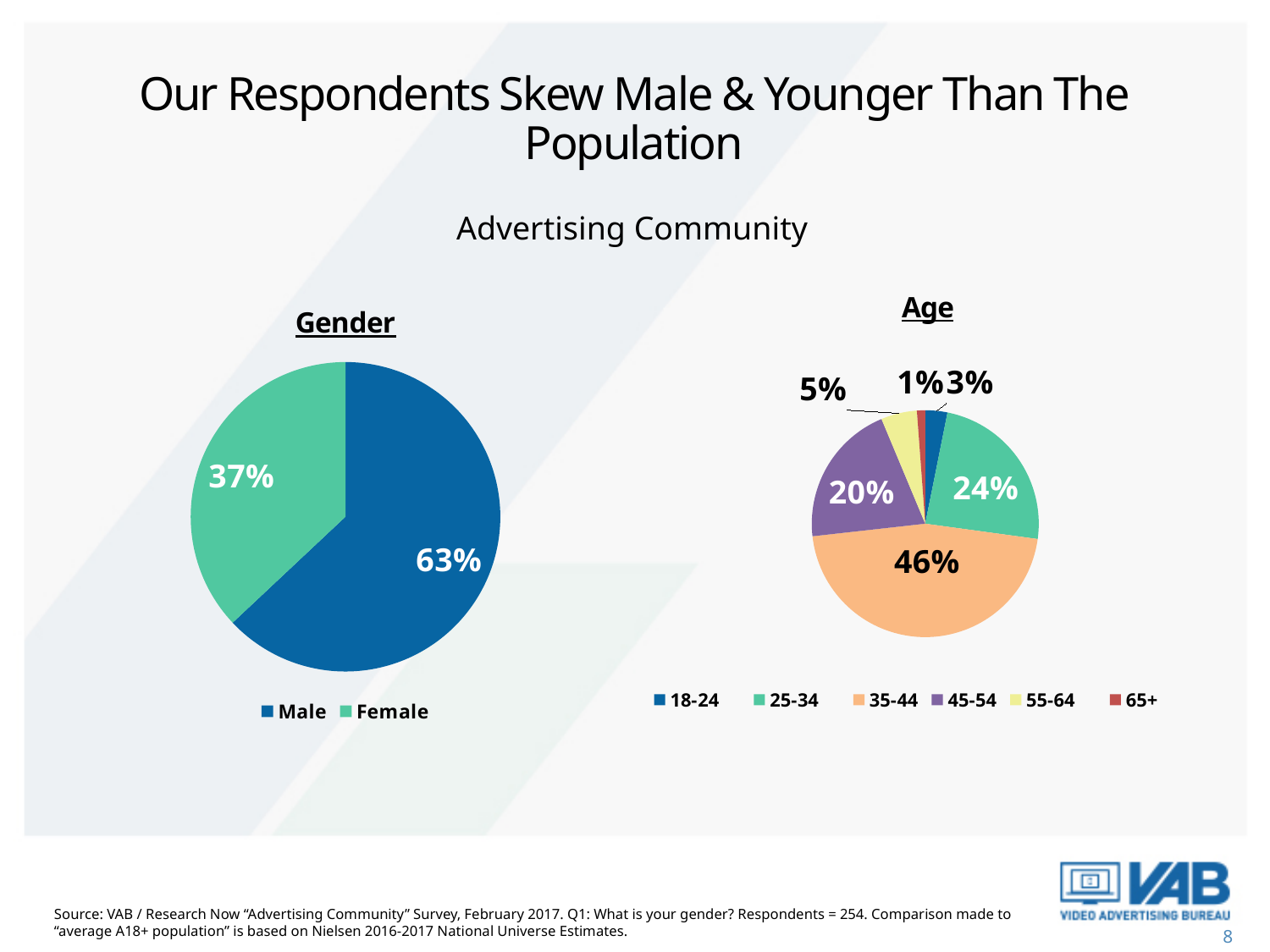
On the Age chart, what is the combined share of the 35-44 and 45-54 groups? 66% On the Age chart, which age group has the smallest share? 65+ On the Age chart, which age group has the largest share? 35-44 On the Age chart, what percentage of respondents are aged 45-54? 20% On the Age chart, what percentage of respondents are aged 35-44? 46% On the Age chart, which is larger, the 25-34 share or the 45-54 share? 25-34 On the Gender chart, what is the difference between the Male and Female shares? 26% On the Age chart, how many age groups does the legend list? 6 On the Age chart, what percentage of respondents are aged 25-34? 24% On the Gender chart, what percentage of respondents are Male? 63% On the Gender chart, what percentage of respondents are Female? 37% What type of chart is the Gender chart? Pie chart